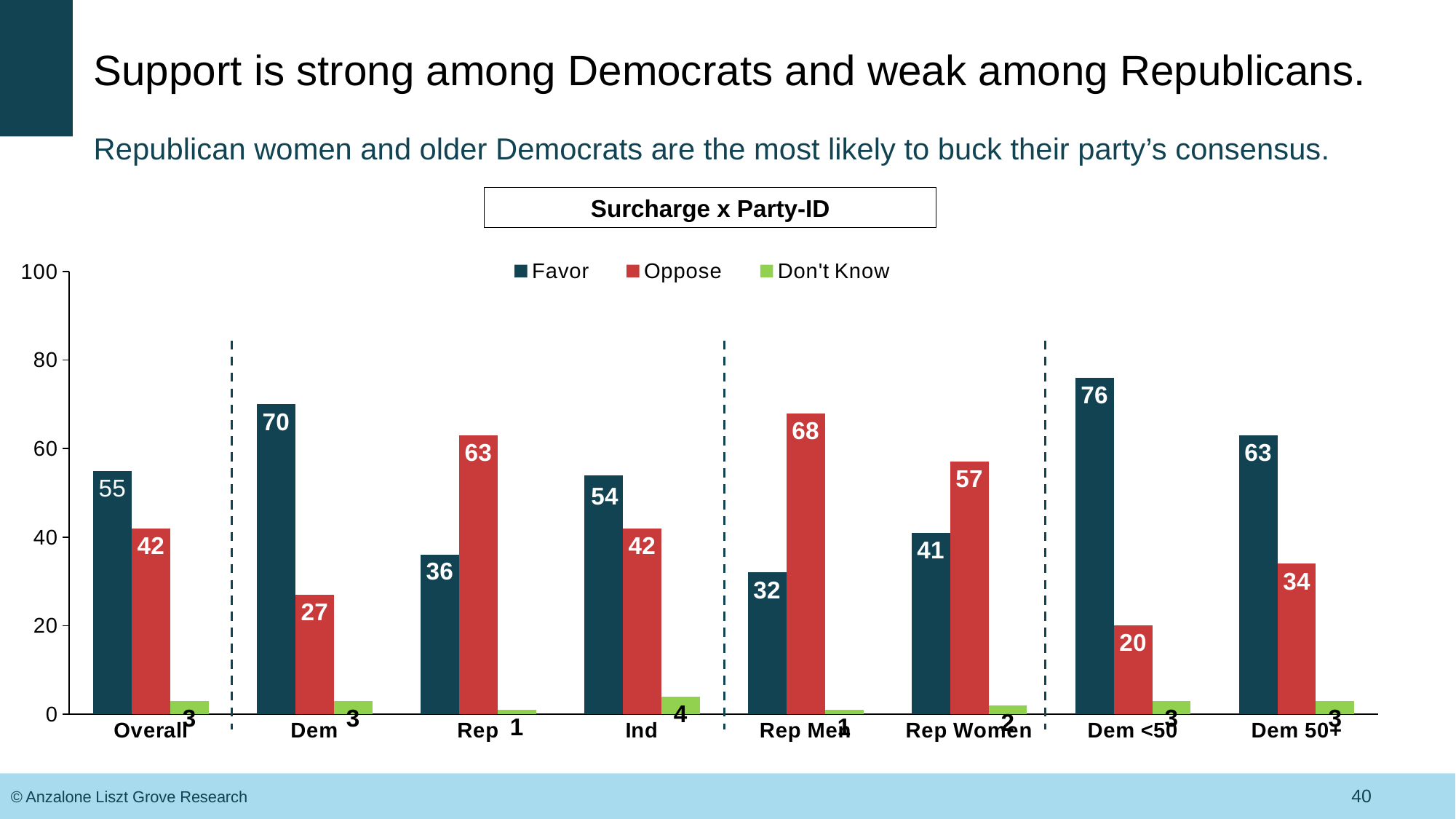
What is the Don't Know value for Ind? 4 What kind of chart is shown? bar chart How many series does the legend list? 3 Which category has the highest Favor value? Dem <50 Is the Favor value for Dem 50+ greater or less than 60? greater Is the Oppose value larger for Rep or for Rep Women? Rep Which category has the lowest Favor value? Rep Men How many categories are shown on the x axis? 8 What is the Oppose value for Rep Men? 68 What is the title of the chart? Surcharge x Party-ID What is the difference between the Favor and Oppose values for Overall? 13 What is the Favor value for Dem? 70